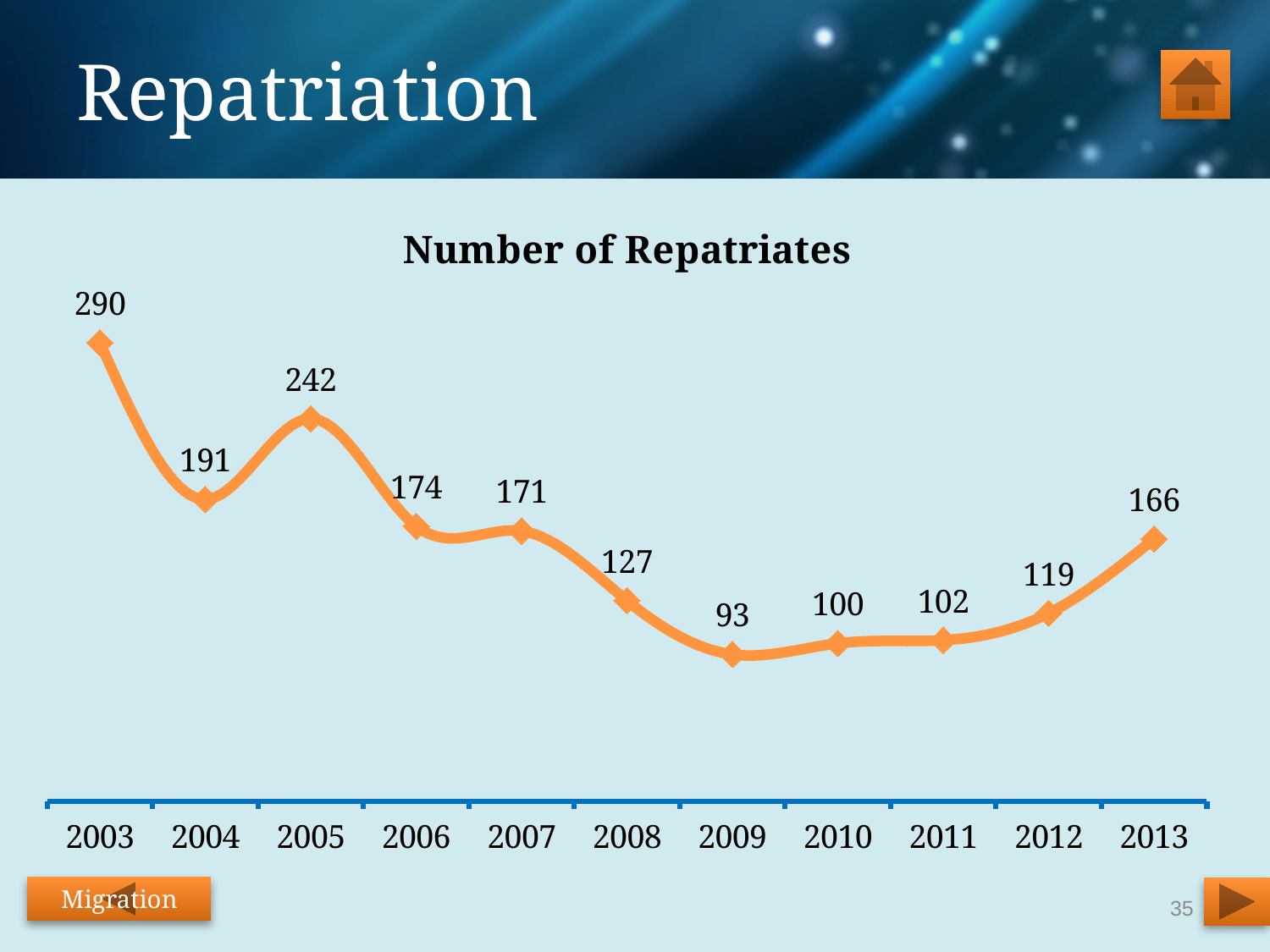
Which year has more repatriates, 2006 or 2007? 2006 What is the difference between the number of repatriates in 2003 and in 2013? 124 What is the title of the chart? Number of Repatriates What is the number of repatriates in 2013? 166 Which year has the highest number of repatriates? 2003 How many years are plotted on the chart? 11 What is the difference between the number of repatriates in 2005 and in 2004? 51 Which year has the lowest number of repatriates? 2009 What kind of chart is shown on the slide? Line chart What is the number of repatriates in 2003? 290 What is the number of repatriates in 2009? 93 Does the number of repatriates rise or fall from 2009 to 2013? Rise